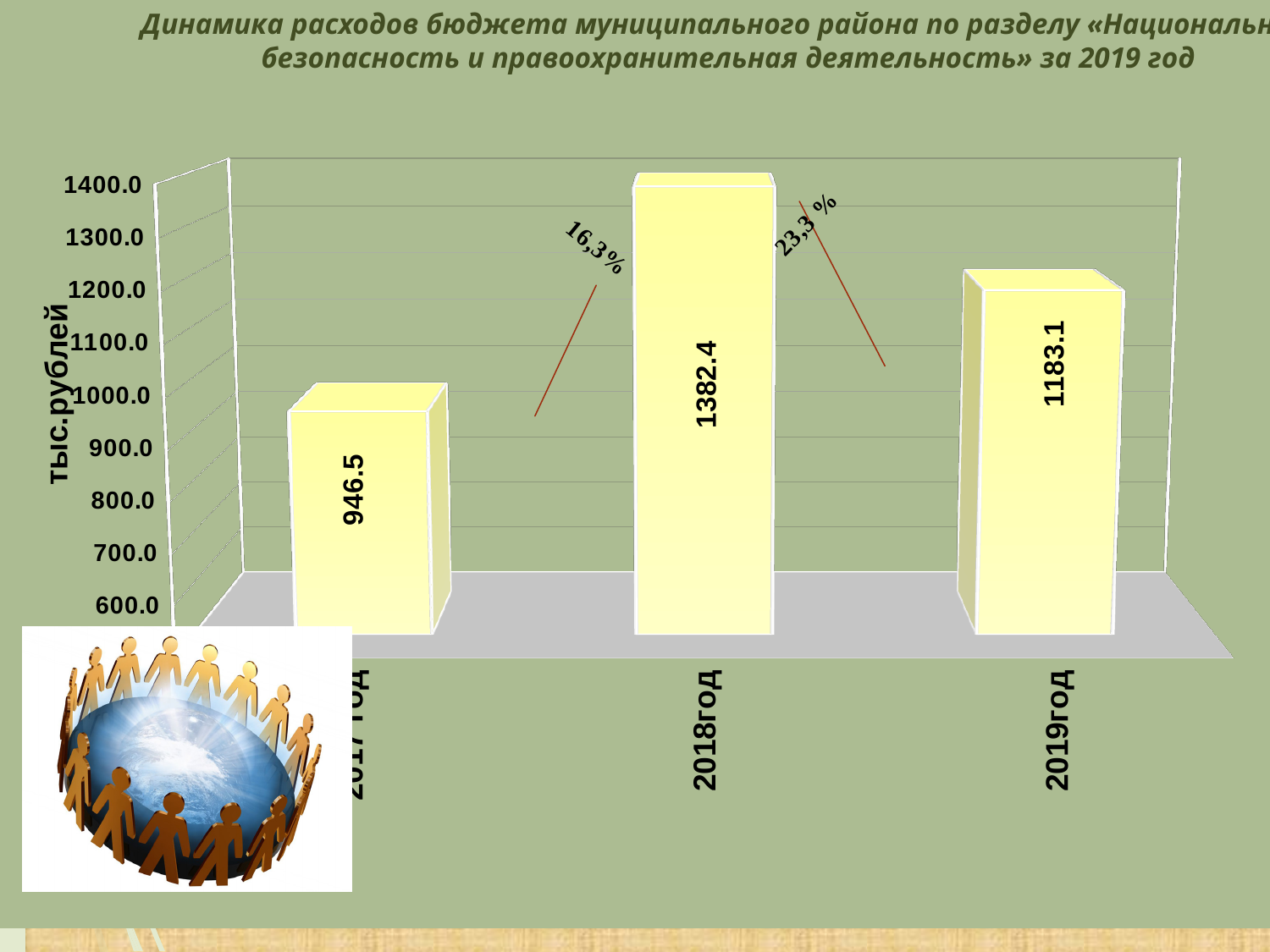
What is the value shown on the leftmost bar? 946.5 What is the value for 2019год? 1183.1 What is the label of the vertical axis? тыс.рублей How many bars are shown in the chart? 3 What is the difference between the value for 2018год and the value of the leftmost bar? 435.9 Which is larger, the value for 2019год or the value of the leftmost bar? 2019год What kind of chart is shown on the slide? bar chart What is the difference between the values for 2018год and 2019год? 199.3 Which bar is the lowest: the leftmost, the middle or the rightmost? leftmost Do the values rise or fall from 2018год to 2019год? fall Which year has the highest value? 2018год What is the value for 2018год? 1382.4